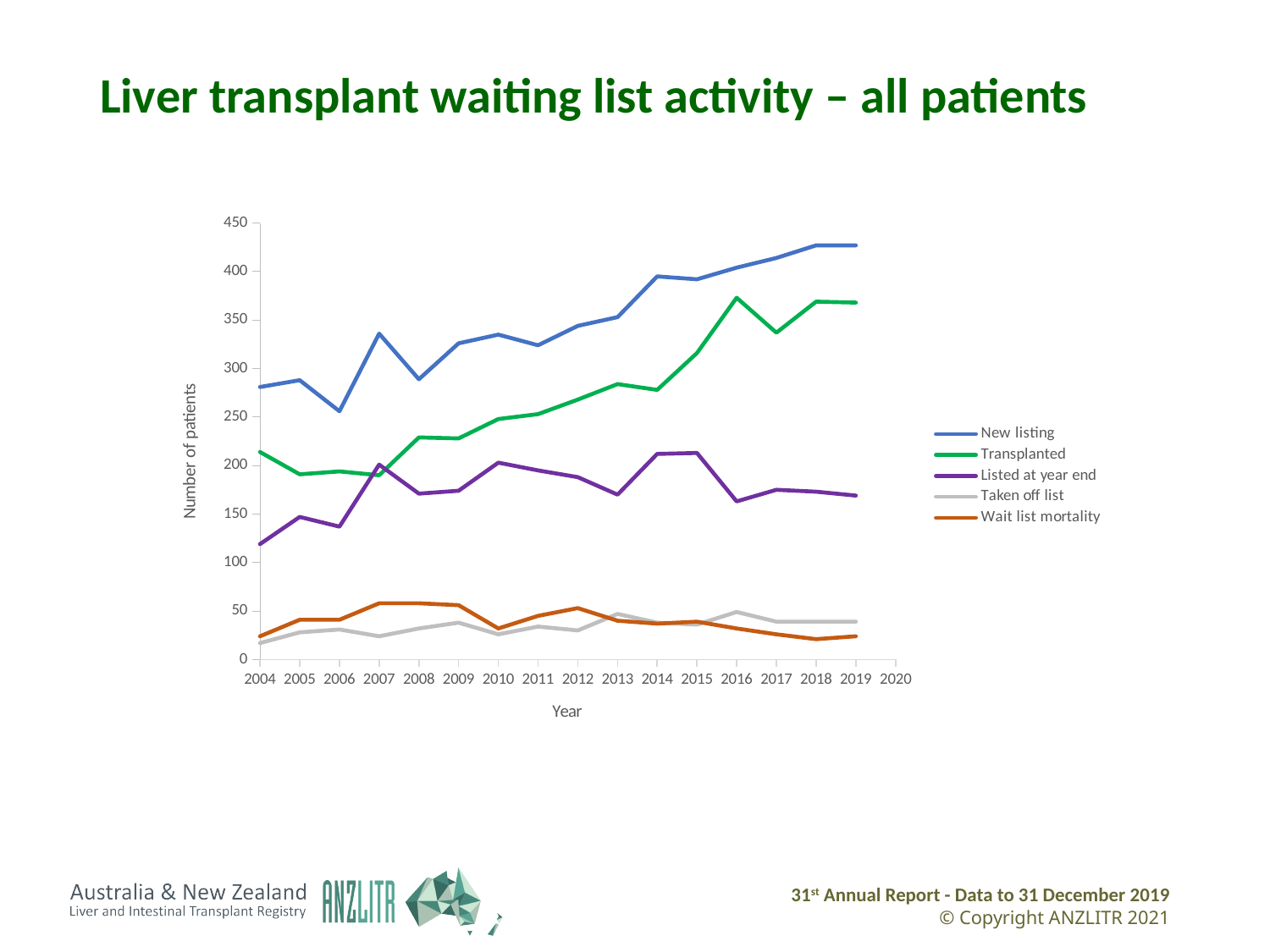
How many series does the legend list? 5 What kind of chart is shown on the slide? line chart Is the value for Transplanted in 2016 greater or less than 350? greater Is the value for Transplanted in 2004 greater or less than 250? less Which series has the highest value in 2019? New listing Is the value for New listing in 2019 greater or less than 400? greater What is the label of the y axis? Number of patients Which series has the lowest value in 2019? Wait list mortality Does the New listing series generally rise or fall from 2004 to 2019? rise In 2019, which is larger: New listing or Transplanted? New listing What are the series listed in the legend? New listing, Transplanted, Listed at year end, Taken off list, Wait list mortality